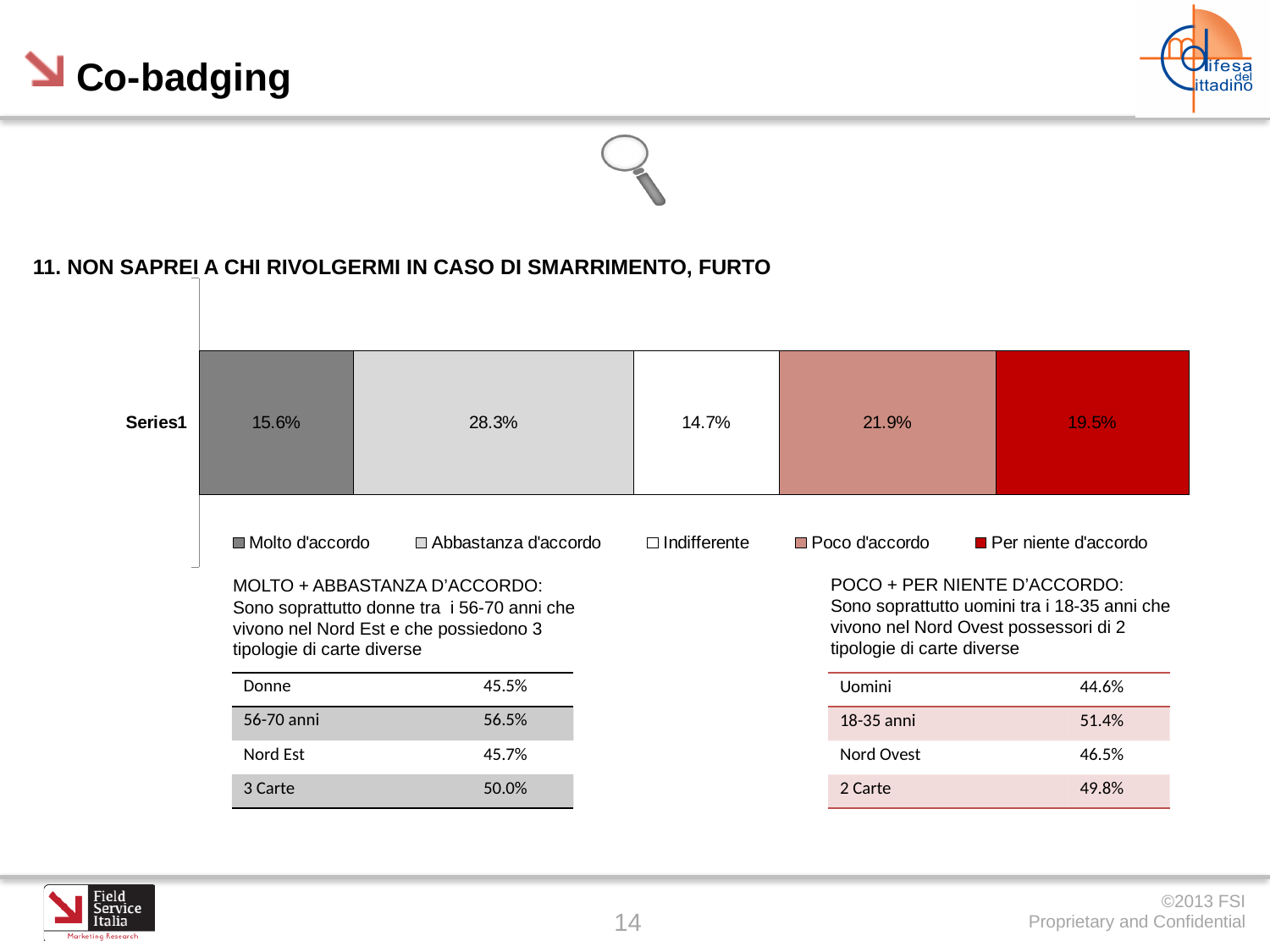
What is the value for Molto d'accordo in the stacked bar? 15.6% Which series has the largest segment in the stacked bar? Abbastanza d'accordo What is the total of all segments in the stacked bar? 100.0% What is the value for Per niente d'accordo in the stacked bar? 19.5% What is the difference between the Abbastanza d'accordo and Molto d'accordo values? 12.7% What is the value for Indifferente in the stacked bar? 14.7% How many series does the legend list? 5 Which is larger, Poco d'accordo or Per niente d'accordo? Poco d'accordo Which series has the smallest segment in the stacked bar? Indifferente What is the value for Poco d'accordo in the stacked bar? 21.9% What kind of chart is shown on the slide? Stacked bar chart What is the value for Abbastanza d'accordo in the stacked bar? 28.3%